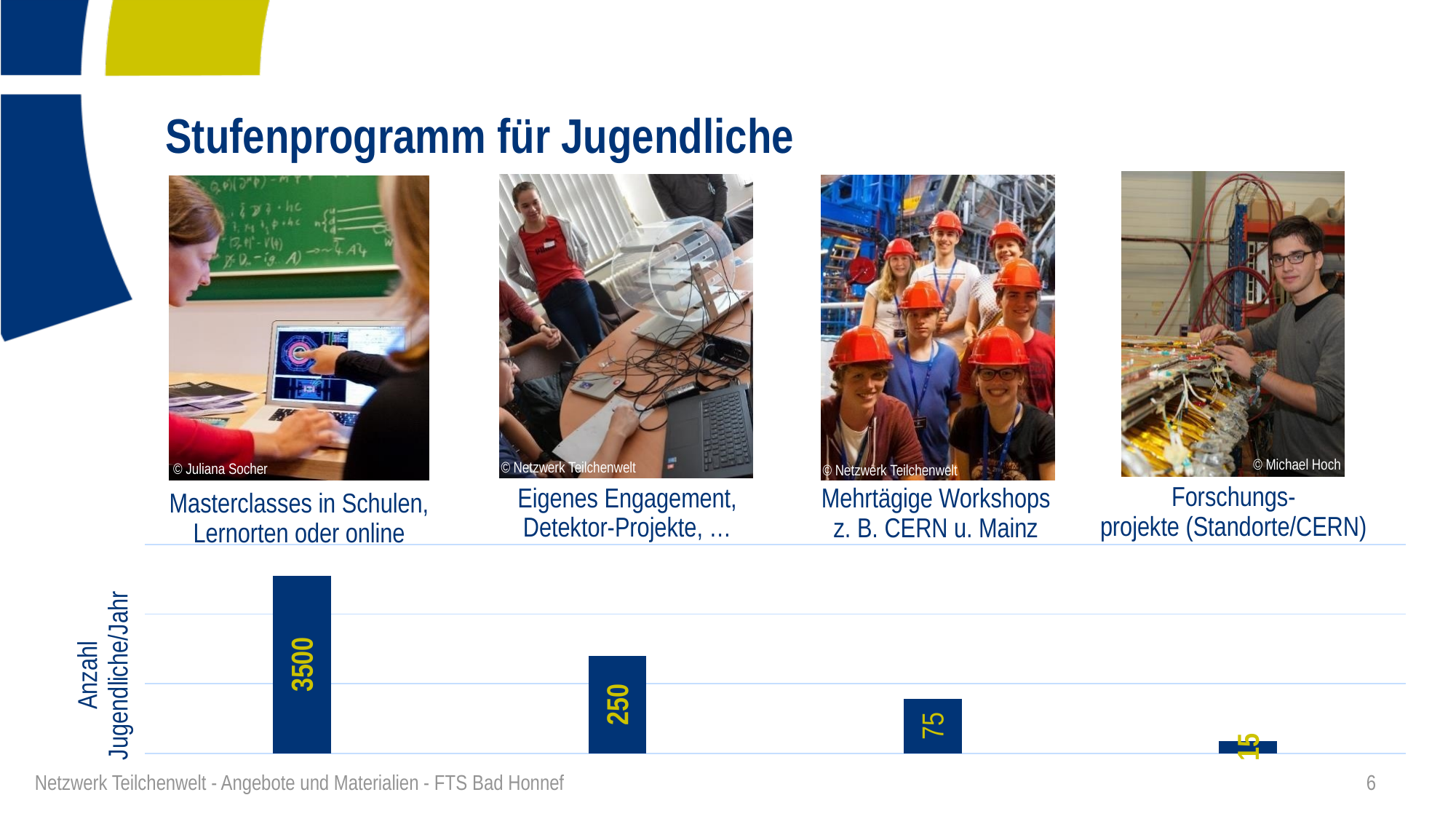
What kind of chart is shown on the slide? bar chart How many bars does the chart show? 4 Do the values rise or fall from left to right across the chart? fall Which is larger, the value for Eigenes Engagement, Detektor-Projekte or the value for Mehrtägige Workshops? Eigenes Engagement, Detektor-Projekte What is the value for Forschungsprojekte (Standorte/CERN)? 15 What is the difference between the values for Mehrtägige Workshops and Forschungsprojekte? 60 What is the difference between the values for Masterclasses and Eigenes Engagement, Detektor-Projekte? 3250 Which category has the lowest value? Forschungsprojekte (Standorte/CERN) What is the value for Mehrtägige Workshops z. B. CERN u. Mainz? 75 What is the value for Masterclasses in Schulen, Lernorten oder online? 3500 Which category has the highest value? Masterclasses in Schulen, Lernorten oder online What is the value for Eigenes Engagement, Detektor-Projekte? 250